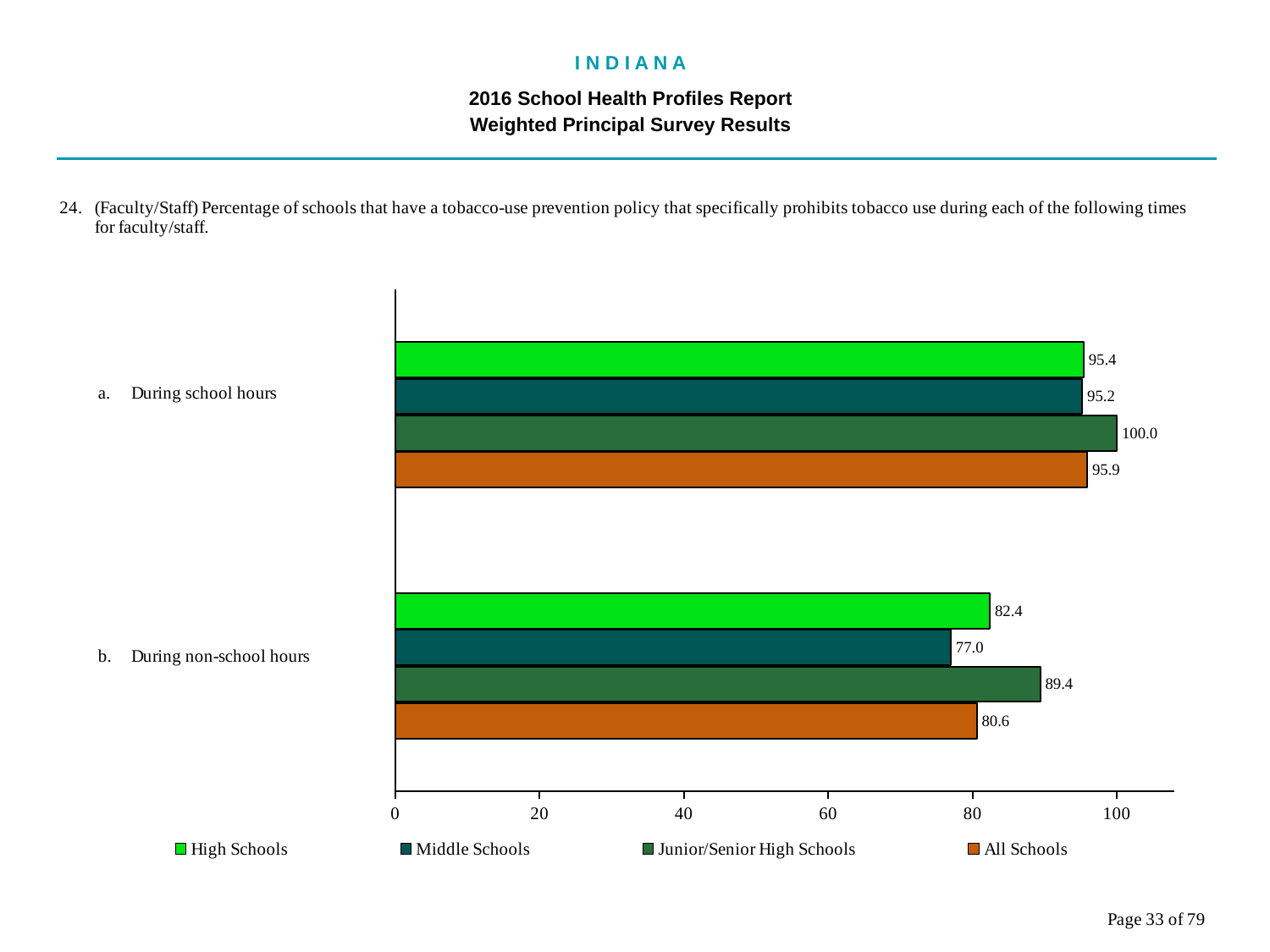
What kind of chart is shown on the slide? Bar chart Which school type has the highest value during non-school hours? Junior/Senior High Schools What is the value for All Schools during non-school hours? 80.6 What is the value for High Schools during school hours? 95.4 What is the difference between the High Schools values for school hours and non-school hours? 13.0 What is the value for Junior/Senior High Schools during school hours? 100.0 Which school type has the lowest value during non-school hours? Middle Schools What colour represents All Schools in the legend? Orange Which is larger for Middle Schools: the value during school hours or during non-school hours? During school hours What is the value for Middle Schools during non-school hours? 77.0 How many categories (time periods) are shown on the chart? 2 How many series does the legend list? 4